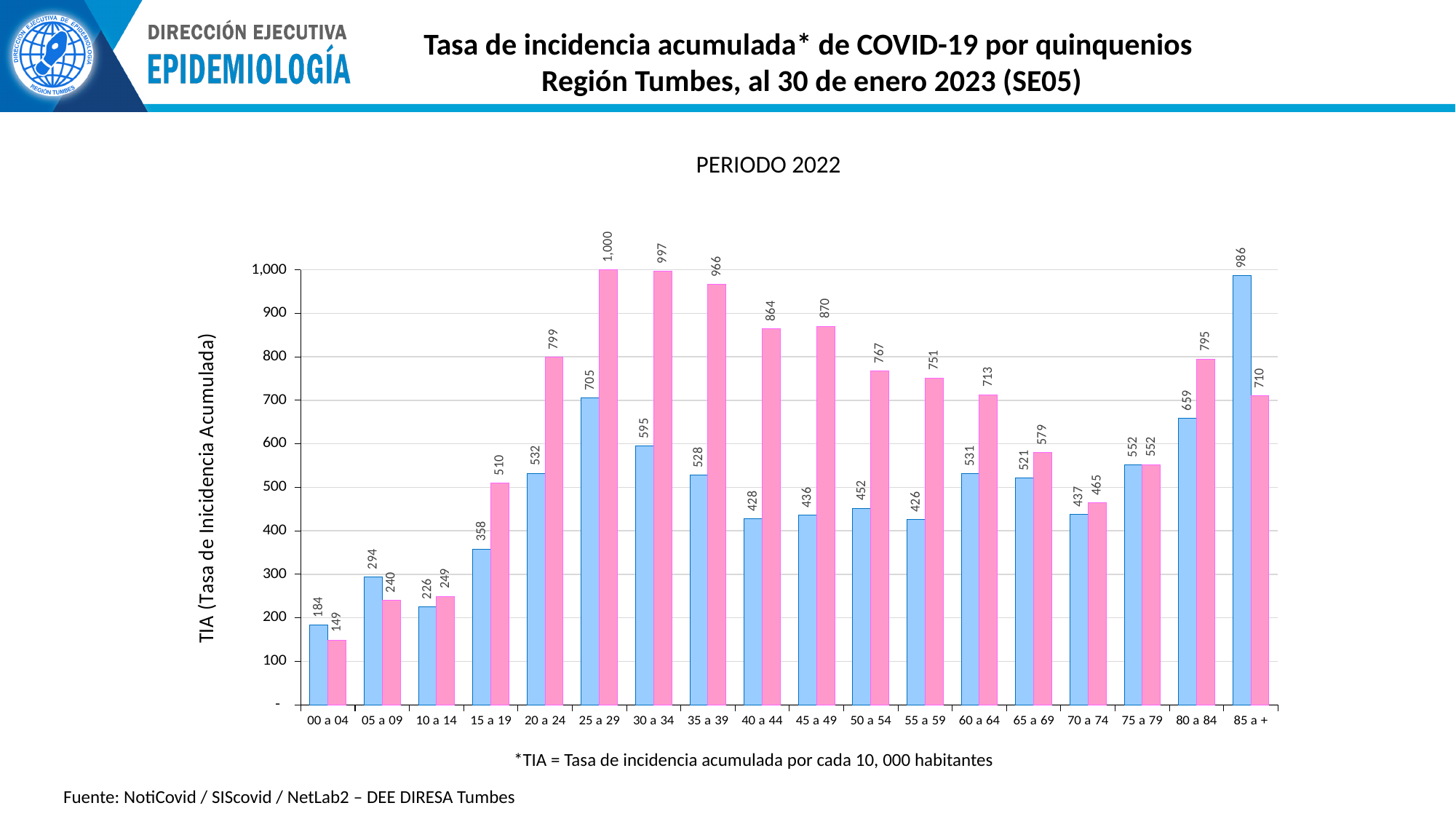
What is the title shown above the chart? PERIODO 2022 What kind of chart is shown on the slide? bar chart What is the difference between the blue and pink bars for the 85 a + age group? 276 What is the value of the blue bar for the 85 a + age group? 986 Is the pink bar for the 35 a 39 age group greater or less than 900? greater What is the difference between the pink and blue bars for the 25 a 29 age group? 295 Which age group has the highest pink bar? 25 a 29 For the 05 a 09 age group, which bar is larger, blue or pink? blue What is the value of the pink bar for the 45 a 49 age group? 870 Which age group has the lowest blue bar? 00 a 04 What is the value of the blue bar for the 25 a 29 age group? 705 How many age groups are shown on the x axis? 18